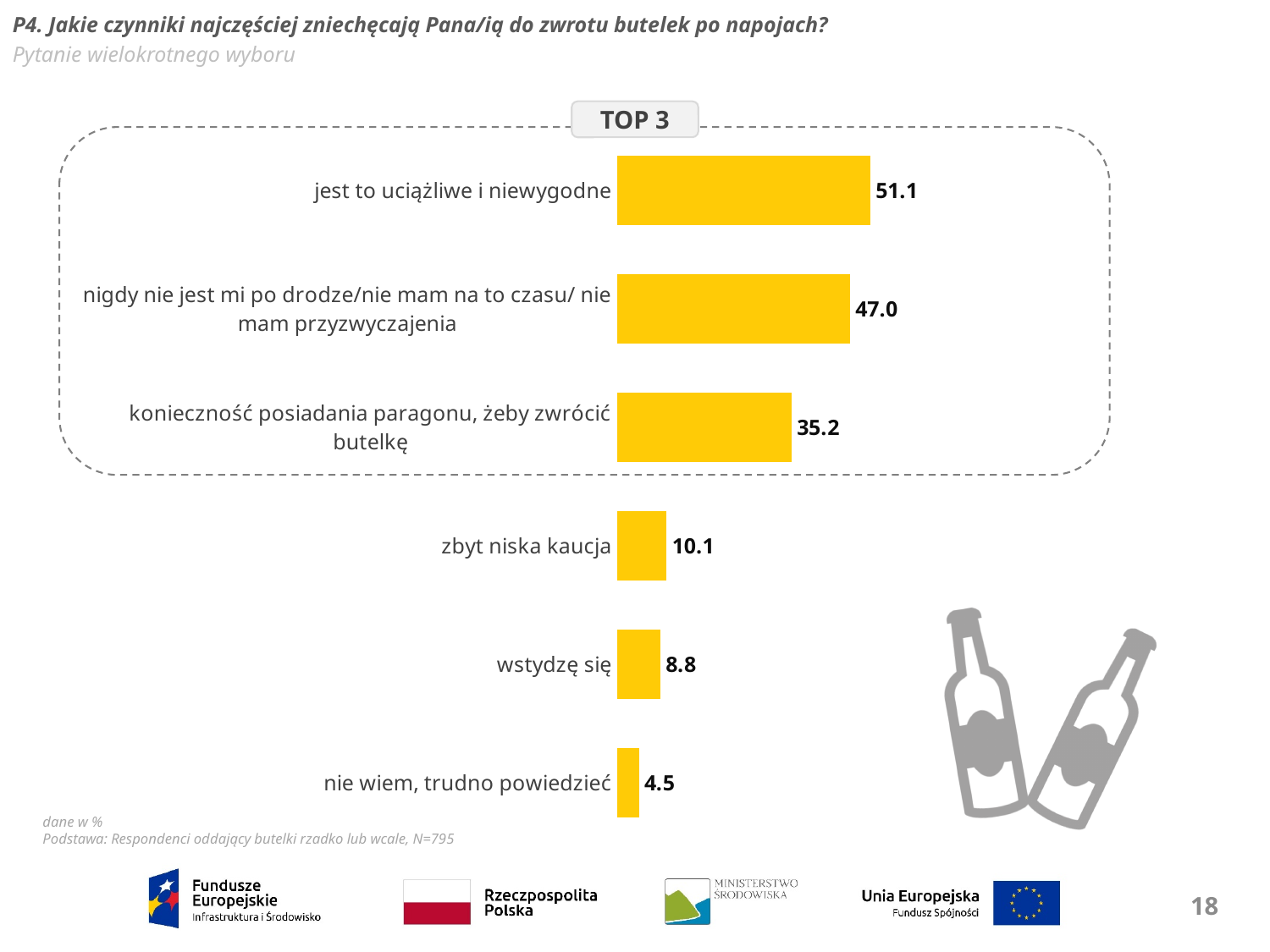
Which category has the highest value? jest to uciążliwe i niewygodne What is the value for "konieczność posiadania paragonu, żeby zwrócić butelkę"? 35.2 What kind of chart is shown on the slide? bar chart Which is larger: the value for "konieczność posiadania paragonu, żeby zwrócić butelkę" or the value for "zbyt niska kaucja"? konieczność posiadania paragonu, żeby zwrócić butelkę What is the difference between the values for "jest to uciążliwe i niewygodne" and "nigdy nie jest mi po drodze/nie mam na to czasu/ nie mam przyzwyczajenia"? 4.1 What is the difference between the values for "zbyt niska kaucja" and "wstydzę się"? 1.3 Which category has the lowest value? nie wiem, trudno powiedzieć What is the value for "nie wiem, trudno powiedzieć"? 4.5 How many categories are enclosed in the dashed box labelled "TOP 3"? 3 What is the value for "jest to uciążliwe i niewygodne"? 51.1 How many categories are shown in the chart? 6 What is the value for "zbyt niska kaucja"? 10.1